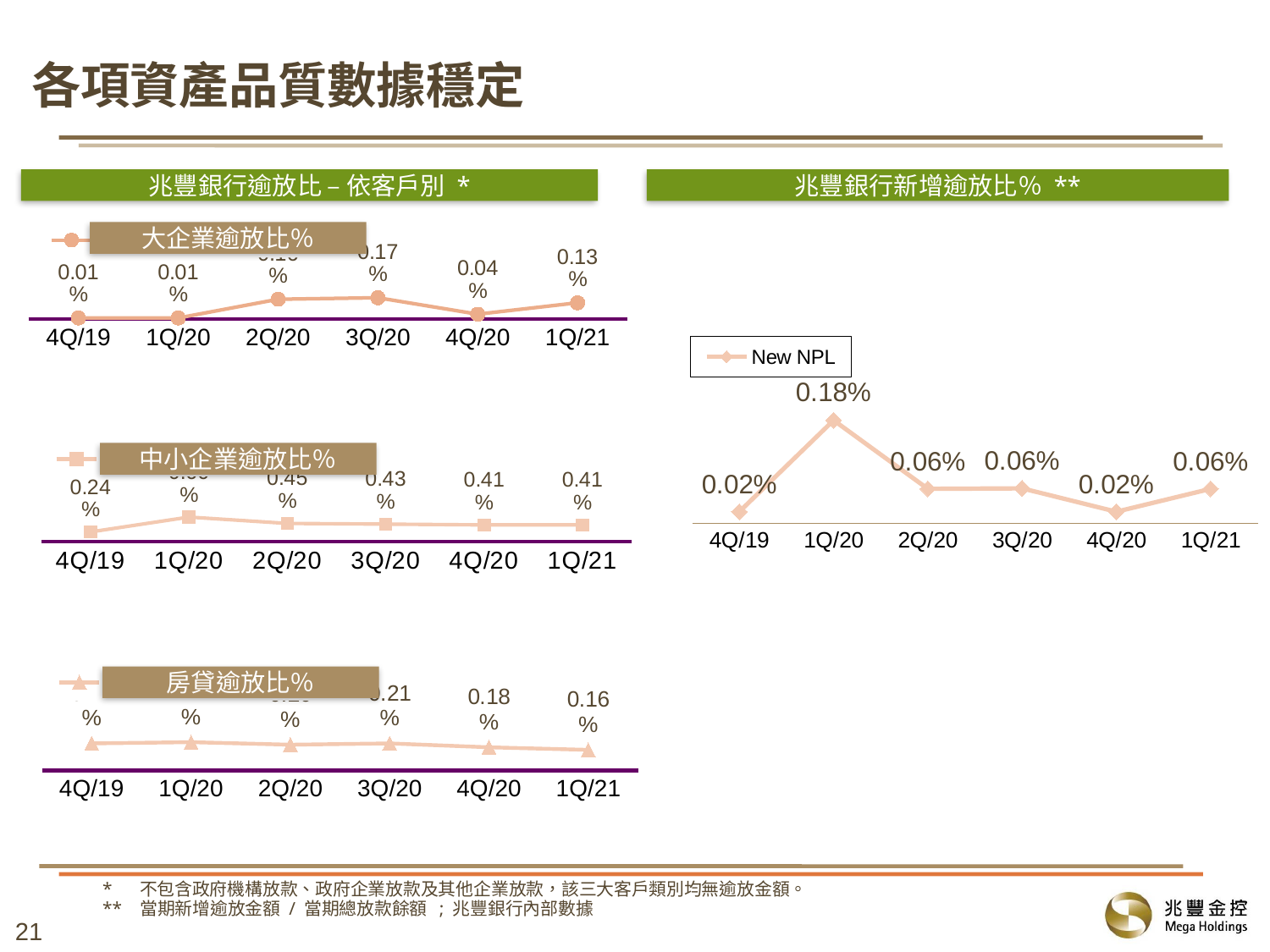
In the 兆豐銀行新增逾放比% chart, what series name does the legend show? New NPL In the 中小企業逾放比% chart, what is the value for 2Q/20? 0.45% In the 兆豐銀行新增逾放比% chart, what is the difference between the 1Q/20 and 2Q/20 values? 0.12% In the 兆豐銀行新增逾放比% chart, which quarter has the highest New NPL value? 1Q/20 In the 兆豐銀行新增逾放比% chart, how many quarters are plotted? 6 In the 大企業逾放比% chart, which is larger, the value for 3Q/20 or 4Q/20? 3Q/20 What kind of chart is the 兆豐銀行新增逾放比% chart? Line chart In the 兆豐銀行新增逾放比% chart, what is the New NPL value for 1Q/20? 0.18% In the 大企業逾放比% chart, what is the value for 3Q/20? 0.17% In the 中小企業逾放比% chart, which quarter has the lowest value? 4Q/19 In the 房貸逾放比% chart, what is the value for 1Q/21? 0.16% In the 房貸逾放比% chart, do the values rise or fall from 3Q/20 to 1Q/21? Fall